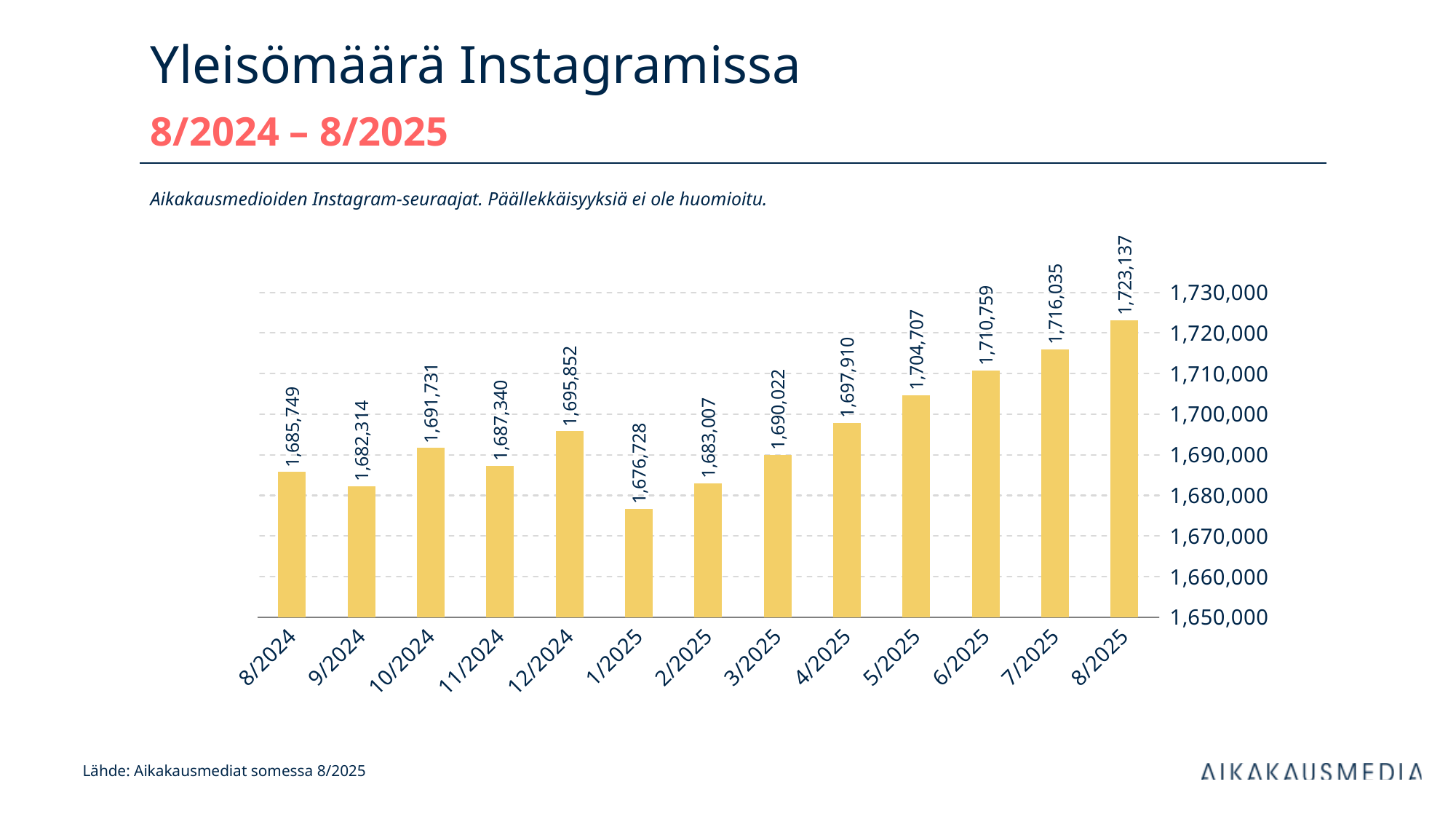
Which is larger, the value for 10/2024 or the value for 11/2024? 10/2024 Do the values rise or fall from 1/2025 to 8/2025? rise Which month has the lowest value? 1/2025 What kind of chart is shown on the slide? bar chart What is the difference between the values for 8/2025 and 8/2024? 37,388 How many months are shown on the x axis? 13 What is the value for 8/2025? 1,723,137 What is the difference between the values for 2/2025 and 1/2025? 6,279 Is the value for 6/2025 greater or less than 1,700,000? greater Which month has the highest value? 8/2025 What is the value for 12/2024? 1,695,852 What is the value for 1/2025? 1,676,728